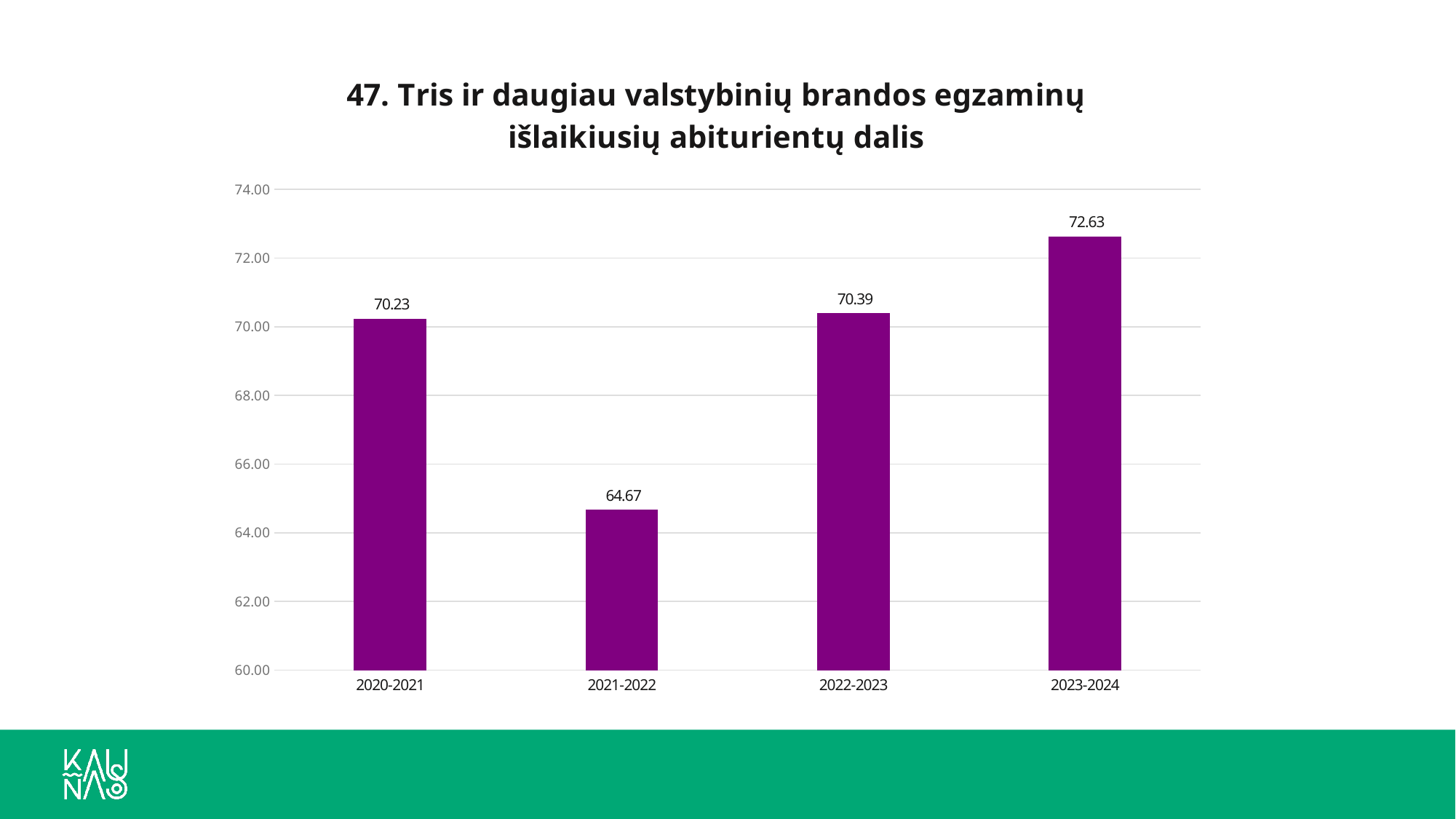
How many school years are shown on the x axis? 4 What kind of chart is shown on the slide? bar chart Which school year has the lowest value? 2021-2022 What is the difference between the values for 2023-2024 and 2021-2022? 7.96 Is the value for 2021-2022 greater or less than 66.00? less Which is larger, the value for 2023-2024 or the value for 2021-2022? 2023-2024 What is the difference between the values for 2023-2024 and 2022-2023? 2.24 What is the value for 2020-2021? 70.23 What is the value for 2022-2023? 70.39 What is the value for 2023-2024? 72.63 What is the value for 2021-2022? 64.67 Which school year has the highest value? 2023-2024